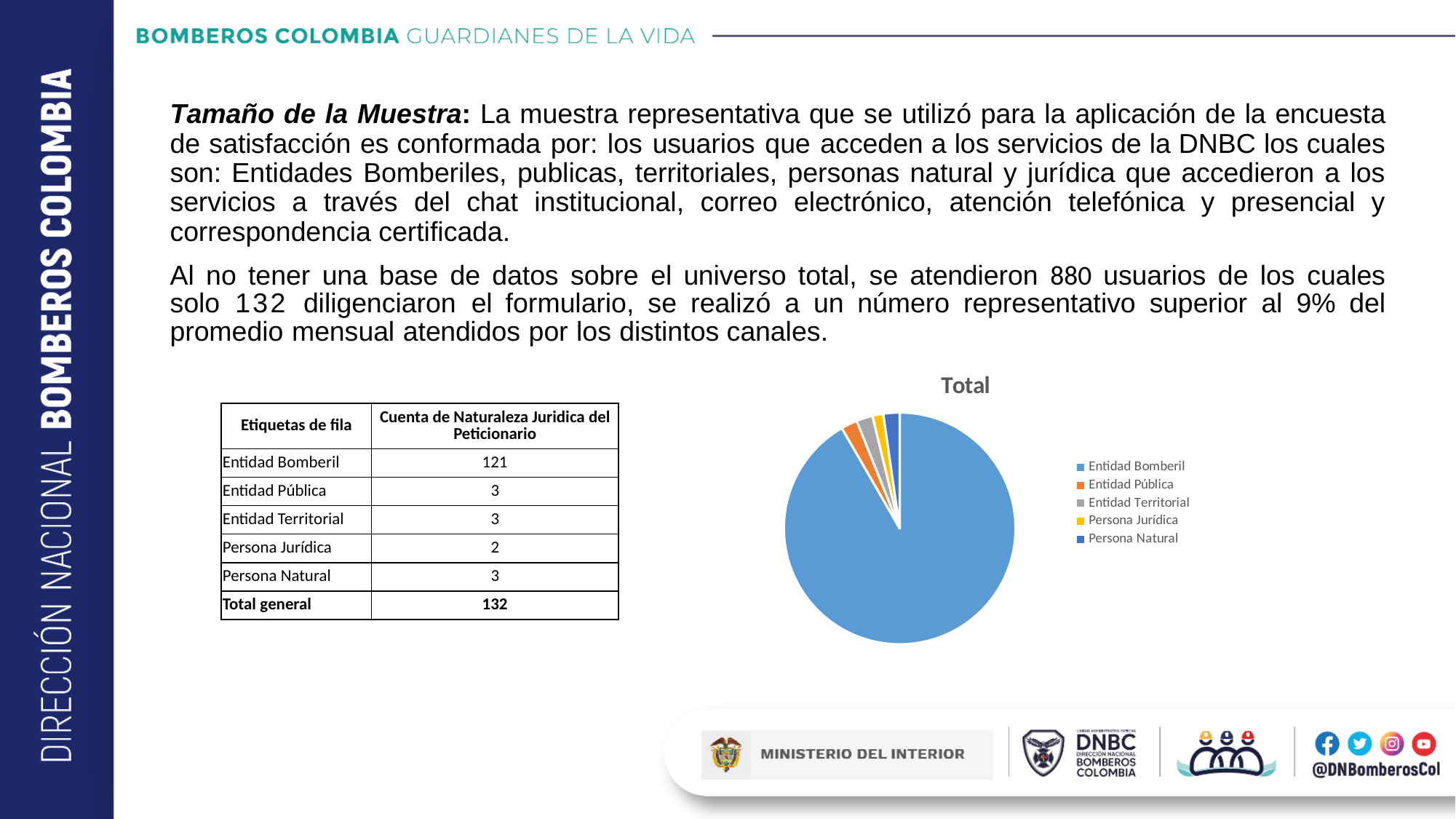
Which is larger, the value for Entidad Bomberil or the value for Persona Natural? Entidad Bomberil What is the title of the pie chart? Total What is the value for Persona Jurídica? 2 Which category has the smallest slice in the pie chart? Persona Jurídica What is the value for Entidad Bomberil? 121 What colour is the slice for Entidad Bomberil in the pie chart? blue Which category has the largest slice in the pie chart? Entidad Bomberil What is the difference between the values for Entidad Bomberil and Entidad Pública? 118 What is the value for Entidad Territorial? 3 How many categories does the pie chart show? 5 What kind of chart is shown on the slide? pie chart How many entries does the legend of the pie chart list? 5